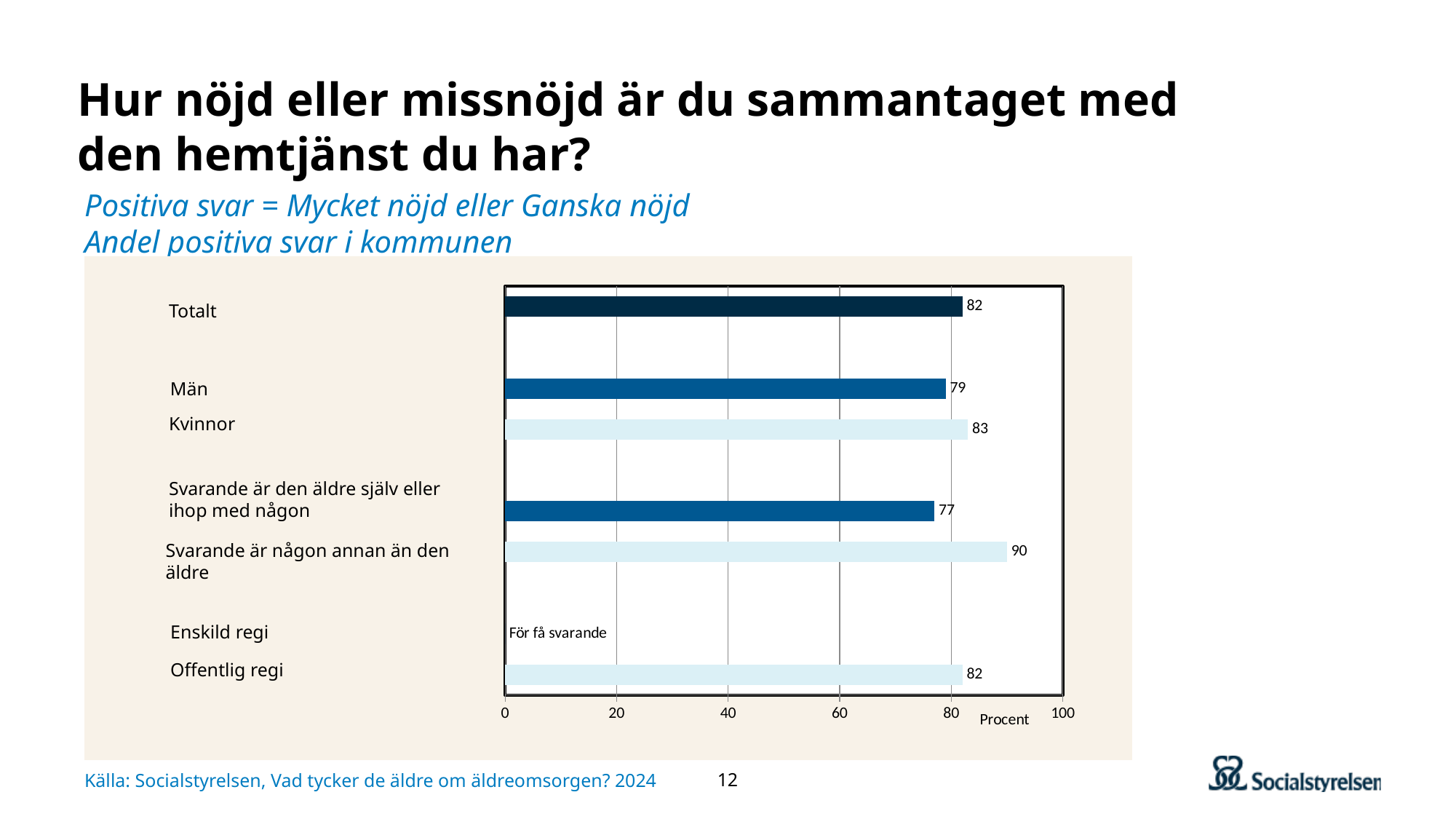
Which category with a plotted bar has the lowest value? Svarande är den äldre själv eller ihop med någon What is the value for Offentlig regi? 82 What is the value for Svarande är någon annan än den äldre? 90 Which category has the highest value? Svarande är någon annan än den äldre Which is larger, the value for Svarande är någon annan än den äldre or the value for Svarande är den äldre själv eller ihop med någon? Svarande är någon annan än den äldre What kind of chart is shown on the slide? Bar chart What is the value for Totalt? 82 What is the value for Män? 79 What is shown instead of a bar for Enskild regi? För få svarande What is the value for Kvinnor? 83 What is the difference between the values for Kvinnor and Män? 4 What unit label is shown on the x axis? Procent